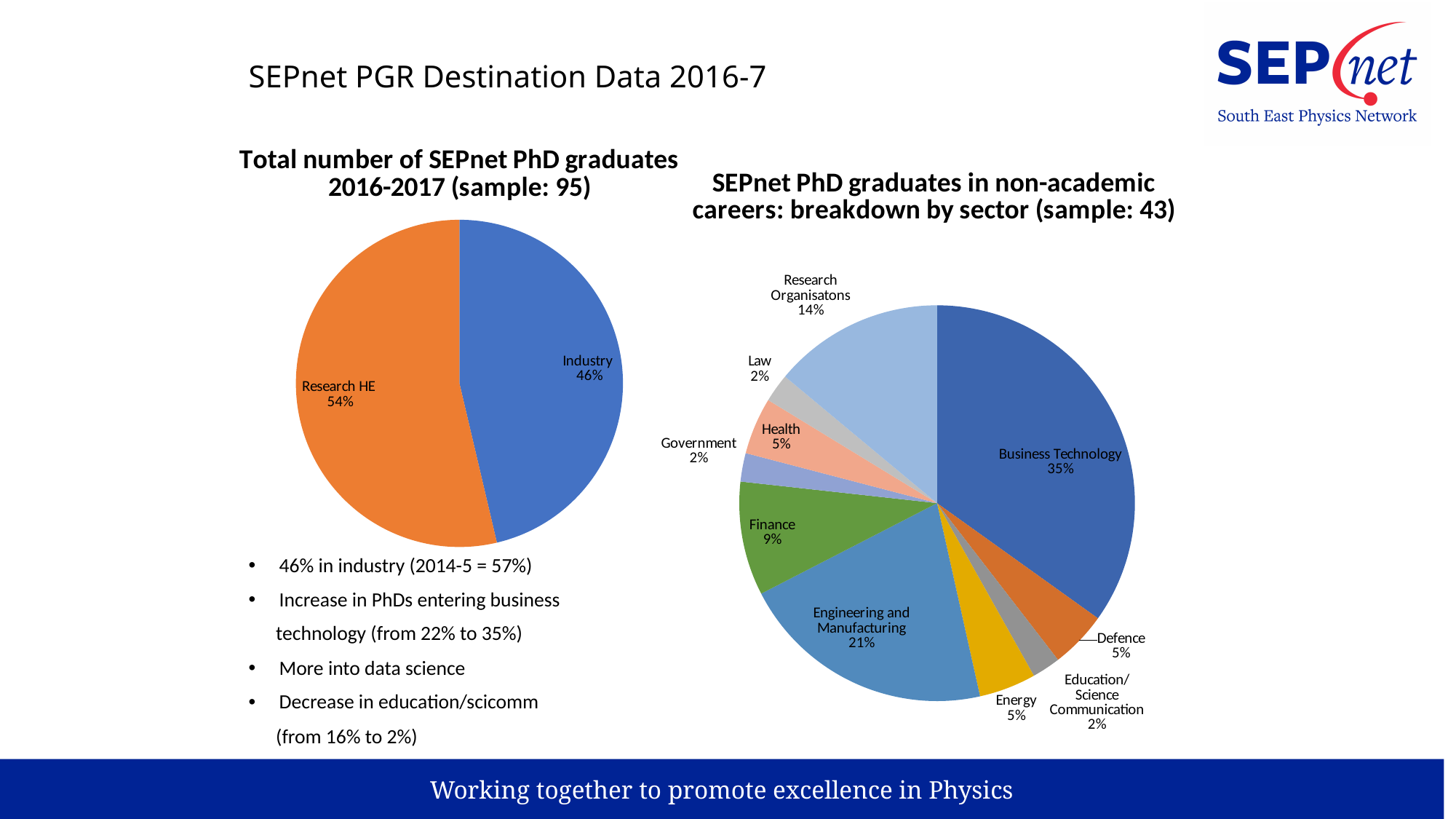
In the 'SEPnet PhD graduates in non-academic careers' pie chart, which sector has the largest share? Business Technology What kind of chart is the 'SEPnet PhD graduates in non-academic careers' chart? Pie chart In the 'SEPnet PhD graduates in non-academic careers' pie chart, how many sectors are shown? 10 In the 'Total number of SEPnet PhD graduates 2016-2017' pie chart, which category has the larger share? Research HE In the 'SEPnet PhD graduates in non-academic careers' pie chart, which is larger, Research Organisatons or Finance? Research Organisatons In the 'Total number of SEPnet PhD graduates 2016-2017' pie chart, what share of graduates went into Industry? 46% In the 'Total number of SEPnet PhD graduates 2016-2017' pie chart, what share of graduates went into Research HE? 54% In the 'Total number of SEPnet PhD graduates 2016-2017' pie chart, how many slices are there? 2 In the 'SEPnet PhD graduates in non-academic careers' pie chart, what is the difference in percentage points between Business Technology and Finance? 26 In the 'SEPnet PhD graduates in non-academic careers' pie chart, what share is Health? 5%